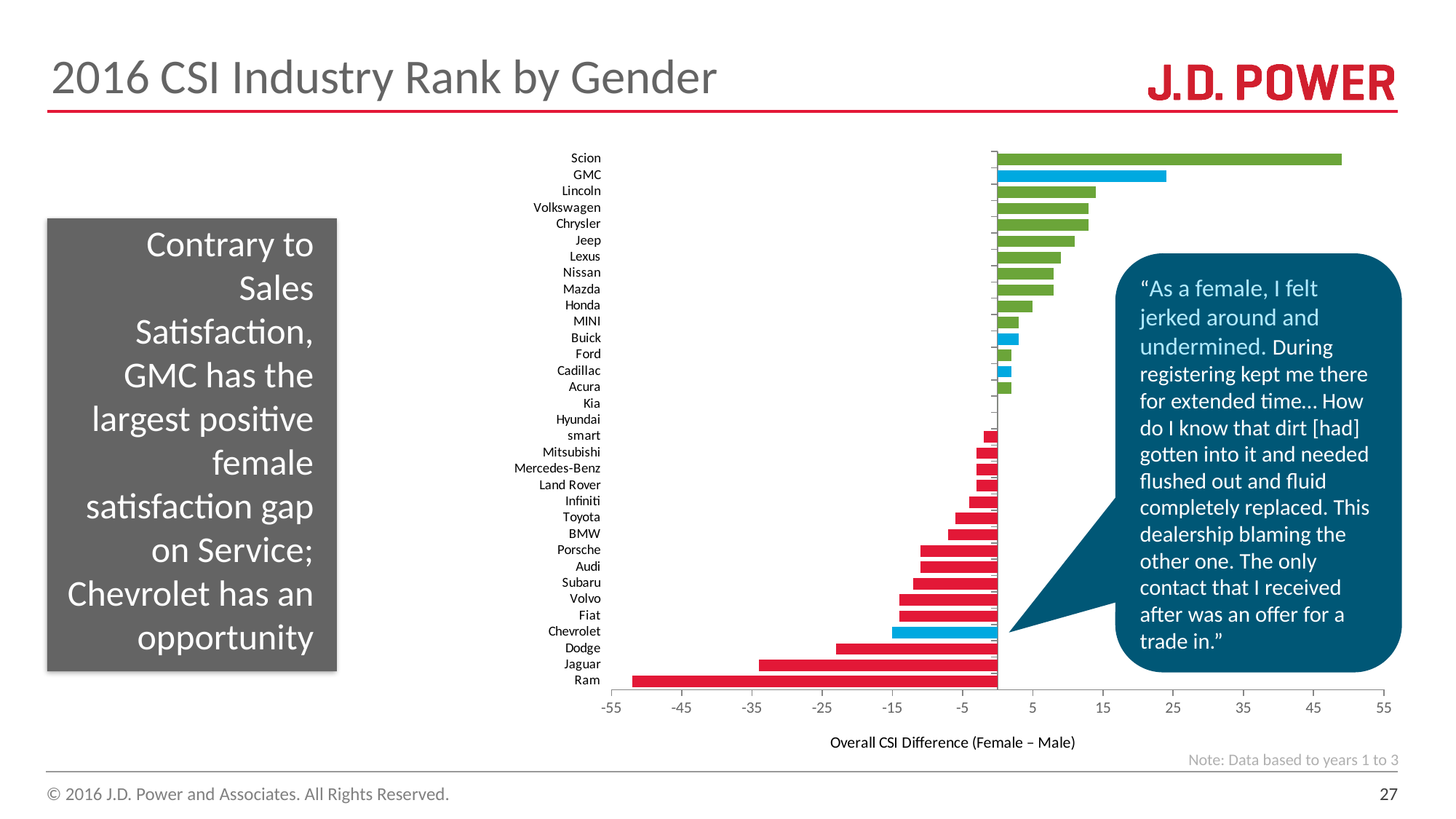
Which has the larger Overall CSI Difference, Lincoln or Honda? Lincoln Which brand has the lowest Overall CSI Difference (Female – Male)? Ram What is the title of the horizontal axis of the chart? Overall CSI Difference (Female – Male) Which has the larger Overall CSI Difference, Scion or GMC? Scion Is the value for Scion greater or less than 45? greater Which brand has the highest Overall CSI Difference (Female – Male)? Scion Is the value for Ram greater or less than -45? less Is the value for Dodge greater or less than -15? less How many brands are listed on the chart? 33 What kind of chart is shown on the slide? bar chart